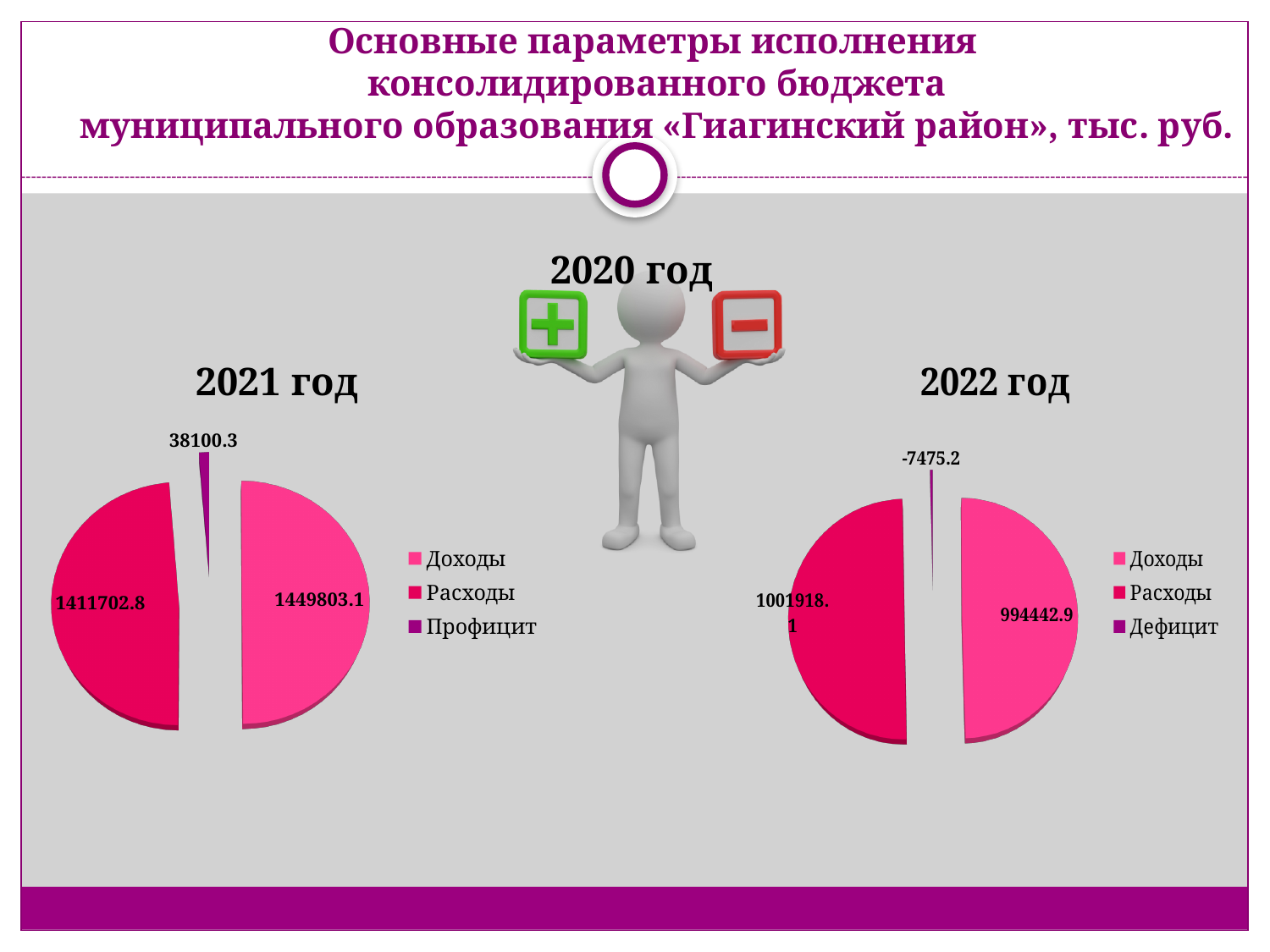
In the 2022 год chart, which is larger, Доходы or Расходы? Расходы In the 2022 год chart, what is the value for Дефицит? -7475.2 In the 2022 год chart, what is the third legend entry after Доходы and Расходы? Дефицит In the 2021 год chart, what is the value for Профицит? 38100.3 In the 2021 год chart, what is the value for Доходы? 1449803.1 In the 2022 год chart, what is the value for Расходы? 1001918.1 In the 2022 год chart, what is the value for Доходы? 994442.9 How many entries does the legend of the 2022 год chart list? 3 In the 2021 год chart, what is the difference between Доходы and Расходы? 38100.3 What type of chart is used for the 2021 год chart? pie chart In the 2021 год chart, which category has the smallest value? Профицит In the 2021 год chart, what is the value for Расходы? 1411702.8